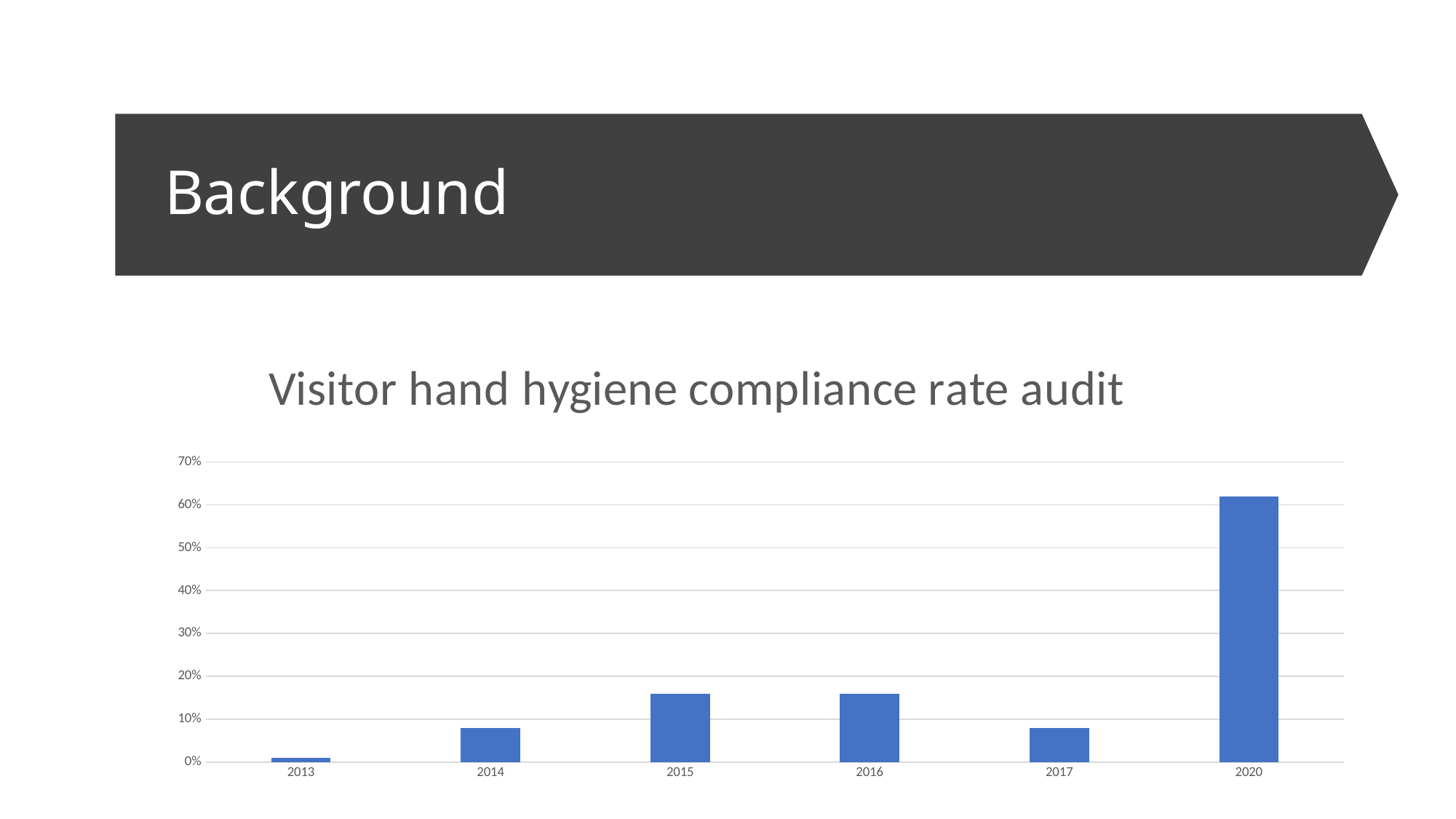
Is the value for 2013 greater or less than 10%? less Is the value for 2020 greater or less than 50%? greater Which year has the lowest visitor hand hygiene compliance rate? 2013 Which year has a higher compliance rate, 2017 or 2020? 2020 Is the value for 2015 greater or less than 10%? greater Which year has a higher compliance rate, 2014 or 2015? 2015 Do the values rise or fall from 2013 to 2015? rise What is the title of the chart? Visitor hand hygiene compliance rate audit Which year has the highest visitor hand hygiene compliance rate? 2020 How many years are shown on the x axis of the chart? 6 What type of chart is shown on the slide? bar chart